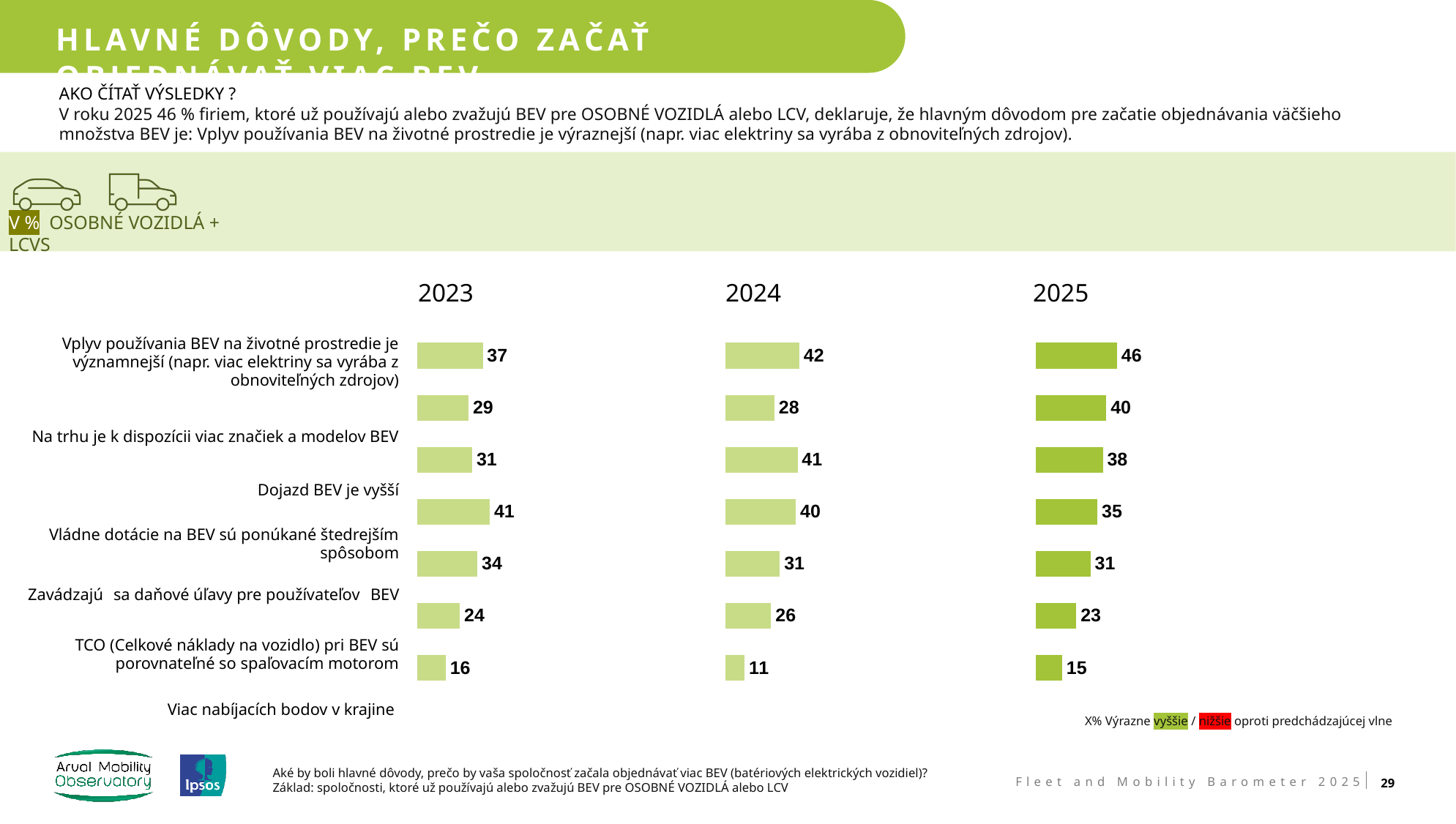
What kind of chart is used to show the 2024 results? Bar chart How many categories are shown in each of the bar charts? 7 In the 2025 chart, what is the value for 'Vplyv používania BEV na životné prostredie je významnejší'? 46 In the 2023 chart, which category has the highest value? Vládne dotácie na BEV sú ponúkané štedrejším spôsobom What is the difference between the 2025 and 2023 values for 'Vplyv používania BEV na životné prostredie je významnejší'? 9 In the 2023 chart, what is the value for 'Vplyv používania BEV na životné prostredie je významnejší'? 37 In the 2023 chart, which category has the lowest value? Viac nabíjacích bodov v krajine How does the value for 'Vplyv používania BEV na životné prostredie je významnejší' change from 2023 to 2025? It rises Is the value for 'Na trhu je k dispozícii viac značiek a modelov BEV' larger in the 2024 chart or the 2025 chart? 2025 In the 2024 chart, what is the value for 'Viac nabíjacích bodov v krajine'? 11 In the 2025 chart, which category has the highest value? Vplyv používania BEV na životné prostredie je významnejší Which three years are shown as chart headings on the slide? 2023, 2024, 2025